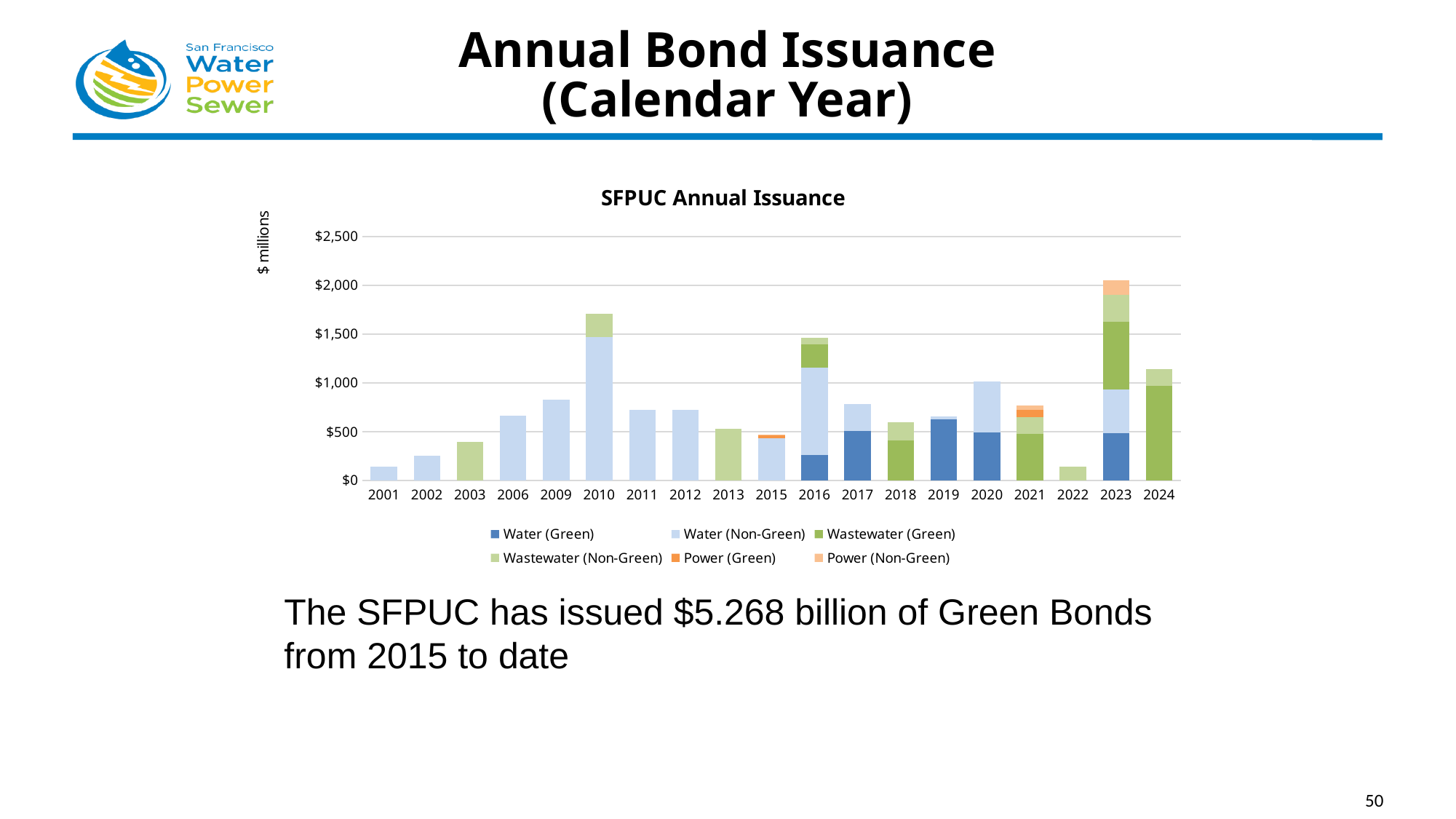
What kind of chart is shown on the slide? Stacked bar chart Which year has the larger total issuance, 2023 or 2024? 2023 Which year has the larger total issuance, 2010 or 2016? 2010 Is the total issuance for 2009 greater or less than $500? greater How many years are shown on the x axis of the SFPUC Annual Issuance chart? 19 Is the total issuance for 2010 greater or less than $1,500? greater Do the total issuance values rise or fall from 2001 to 2010? rise Is the total issuance for 2002 greater or less than $500? less Which year has the highest total bond issuance in the chart? 2023 How many series does the legend of the SFPUC Annual Issuance chart list? 6 What unit is shown on the y axis of the chart? $ millions